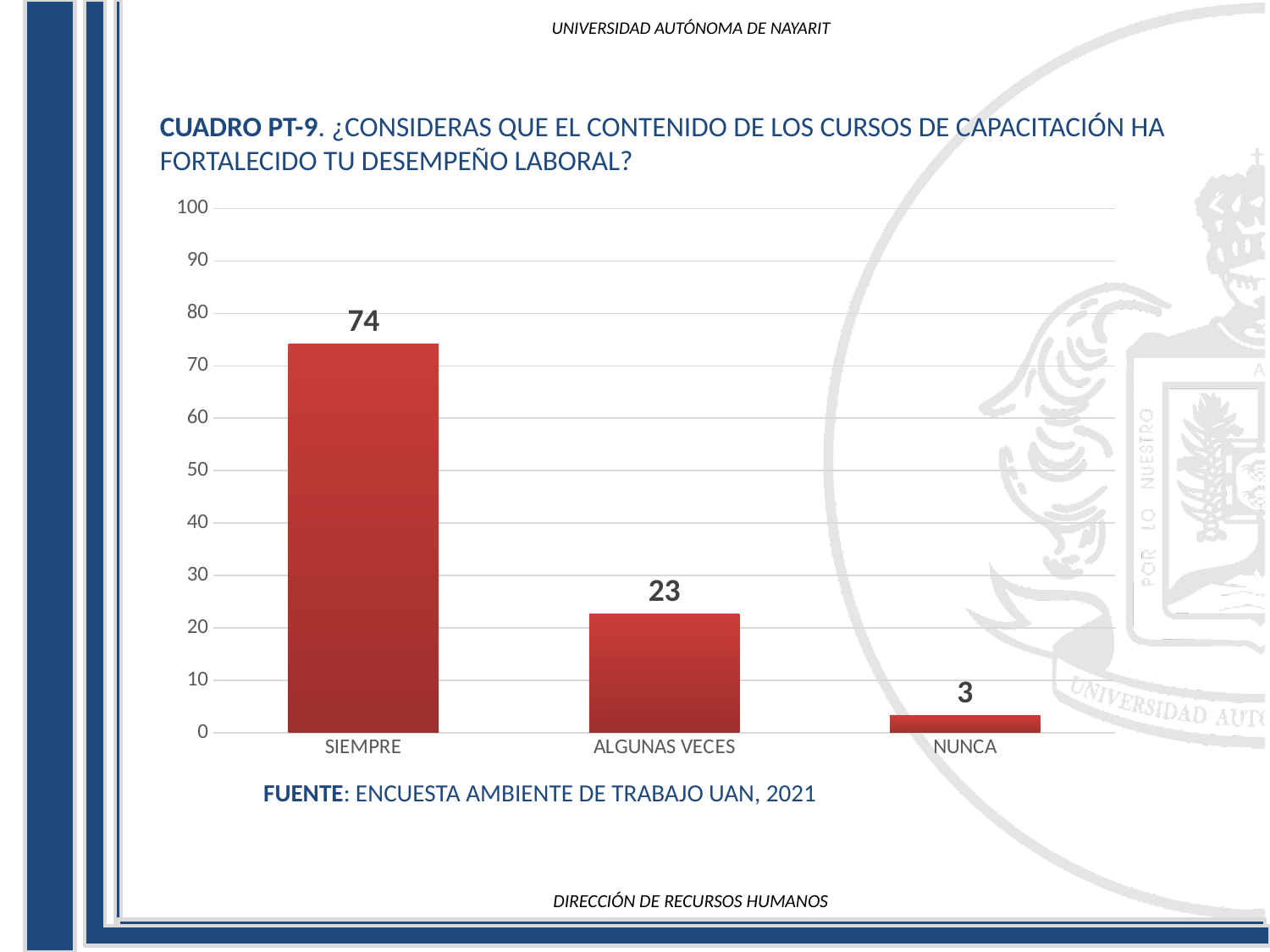
How many categories are shown on the x axis? 3 Is the value for SIEMPRE greater or less than 70? greater Which category has the lowest value? NUNCA Which is larger, the value for ALGUNAS VECES or the value for NUNCA? ALGUNAS VECES Do the values rise or fall from SIEMPRE to NUNCA along the x axis? fall What kind of chart is shown on the slide? bar chart What is the value for ALGUNAS VECES? 23 What is the difference between the values for SIEMPRE and ALGUNAS VECES? 51 What is the value for SIEMPRE? 74 What is the difference between the values for ALGUNAS VECES and NUNCA? 20 What is the value for NUNCA? 3 Which category has the highest value? SIEMPRE